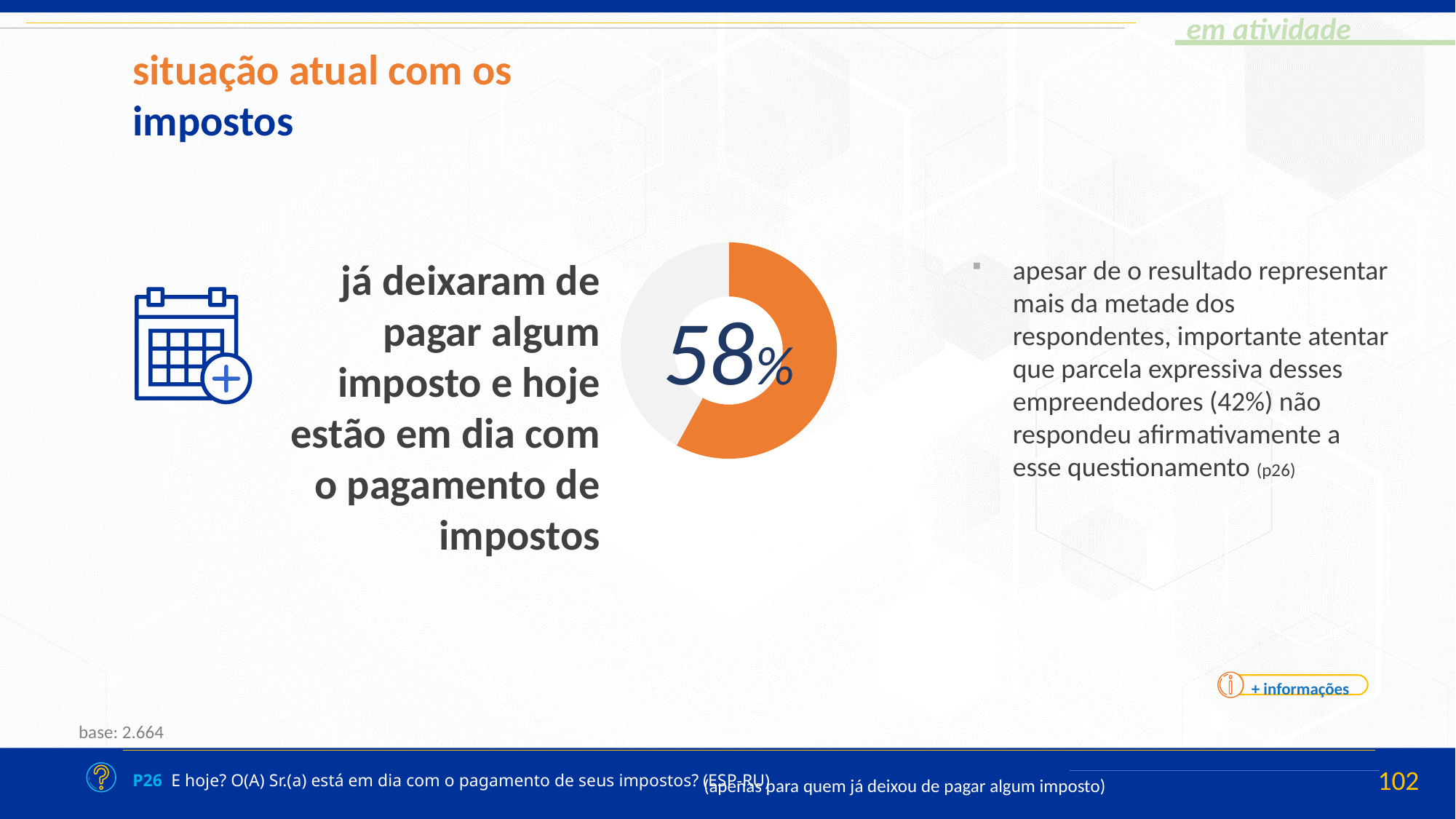
How many slices does the donut chart have? 2 What is the base (number of respondents) stated for the chart? 2.664 What share of respondents who once stopped paying a tax are now up to date with their tax payments, according to the chart? 58% What is the difference between the orange share (58%) and the grey share (42%) of the donut chart? 16% What kind of chart is shown on the slide? Donut (pie) chart Is the highlighted value in the donut chart greater or less than 50%? greater What percentage is printed in the centre of the donut chart? 58% Which slice of the donut chart is larger, the orange one or the grey one? The orange one What colour is the slice representing the 58% in the donut chart? Orange According to the slide, what percentage of these entrepreneurs did not answer affirmatively (the grey portion of the donut)? 42%